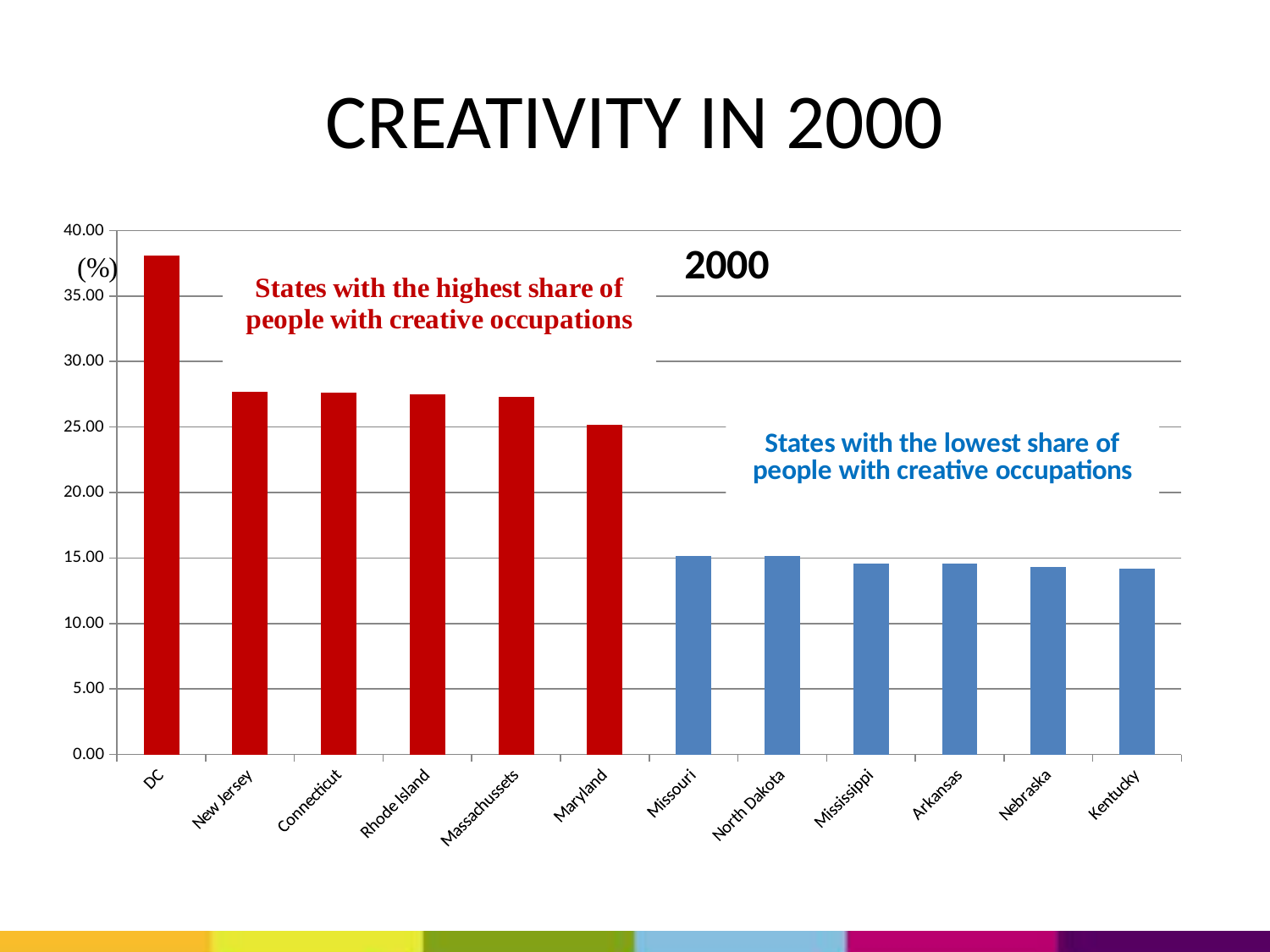
Is the value for Kentucky greater or less than 20? less Which is larger, the value for Maryland or the value for Missouri? Maryland Is the value for Mississippi greater or less than 20? less Which state has the highest share of people with creative occupations in the chart? DC Is the value for Maryland greater or less than 20? greater What colour are the bars for the states with the lowest share of people with creative occupations? blue Do the values generally rise or fall moving from left to right along the x axis? fall What kind of chart is shown on the slide? bar chart How many states are shown on the x axis of the chart? 12 What is the title shown inside the chart area? 2000